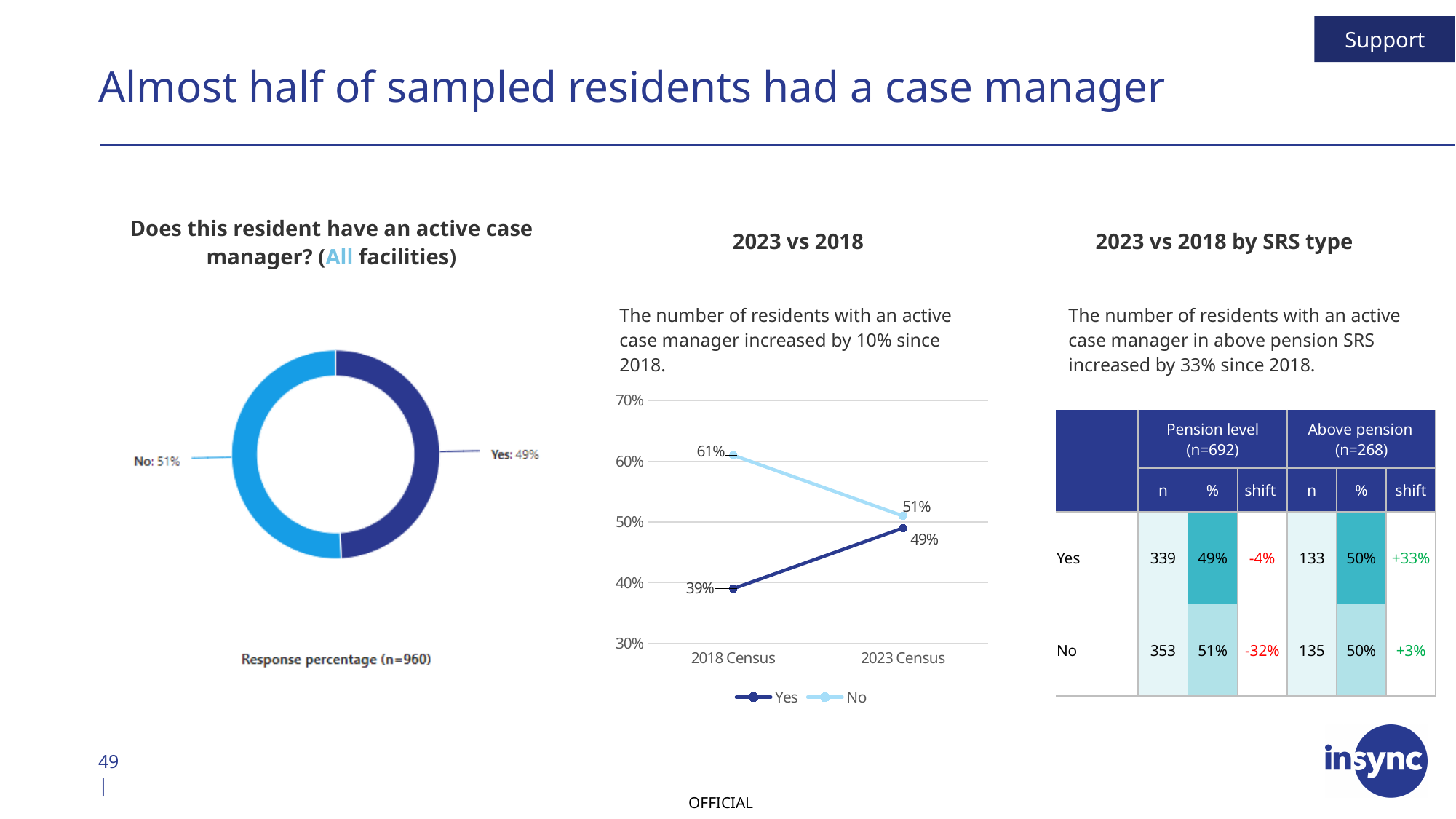
In the '2023 vs 2018' line chart, by how many percentage points did the Yes value change from the 2018 Census to the 2023 Census? 10% In the donut chart 'Does this resident have an active case manager? (All facilities)', what percentage of residents answered Yes? 49% How many series does the legend of the '2023 vs 2018' line chart list? 2 What type of chart is the '2023 vs 2018' chart in the middle of the slide? line chart In the '2023 vs 2018' line chart, what was the No value in the 2023 Census? 51% In the '2023 vs 2018' line chart, what is the difference between the No value in 2018 and the No value in 2023? 10% In the '2023 vs 2018' line chart, does the No series rise or fall from the 2018 Census to the 2023 Census? fall In the '2023 vs 2018' line chart, does the Yes series rise or fall from the 2018 Census to the 2023 Census? rise What is the sample size shown under the donut chart on the left? n=960 In the donut chart on the left, which response has the larger share, Yes or No? No In the donut chart 'Does this resident have an active case manager? (All facilities)', what percentage of residents answered No? 51% In the '2023 vs 2018' line chart, what was the Yes value in the 2018 Census? 39%